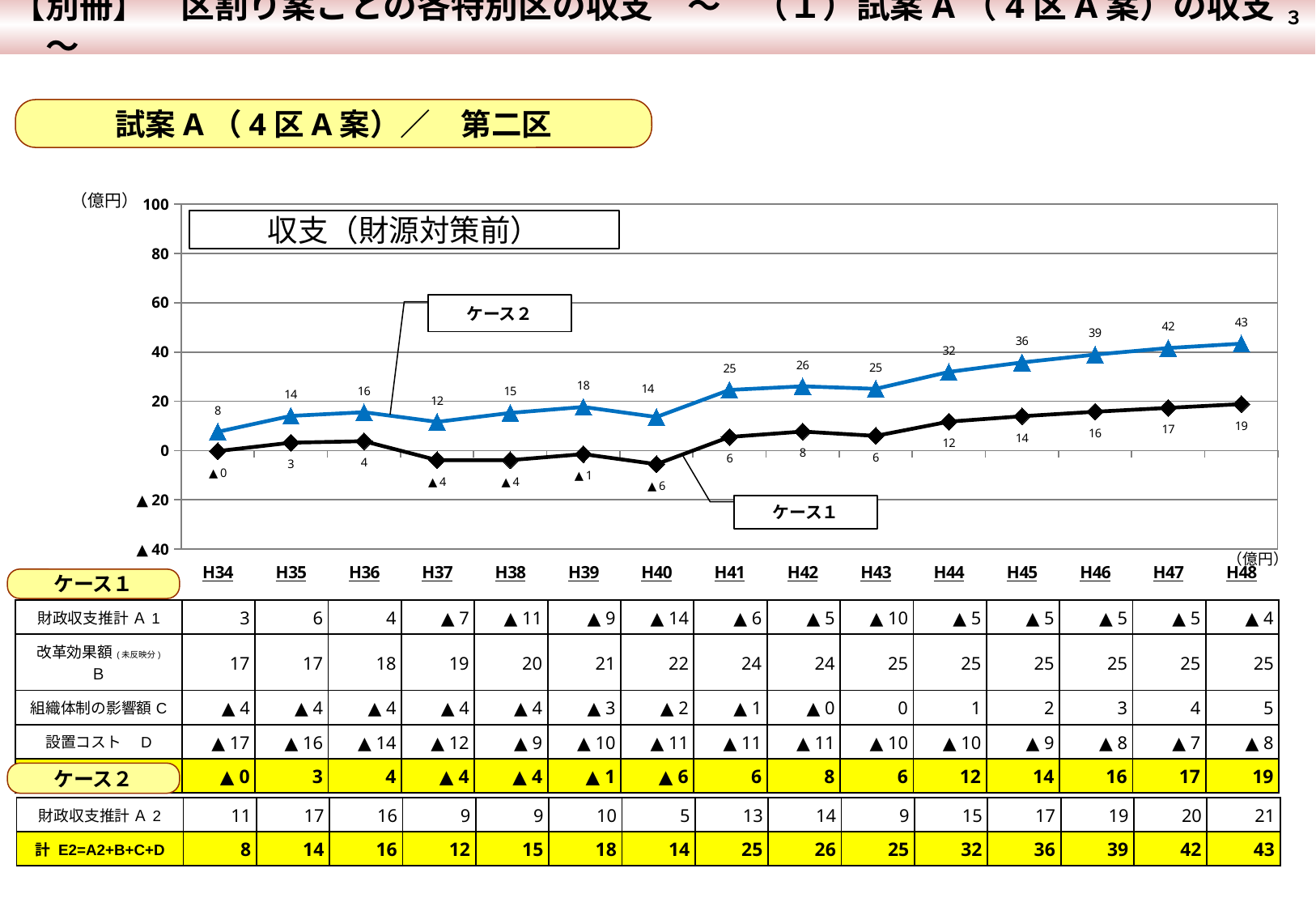
In the chart 収支（財源対策前）, which series has the higher value at H41, ケース1 or ケース2? ケース2 In the chart 収支（財源対策前）, at which year does ケース1 reach its lowest value? H40 In the chart 収支（財源対策前）, what is the difference between ケース2 and ケース1 at H48? 24 In the chart 収支（財源対策前）, is the value for ケース2 at H44 greater or less than 20? greater How many series are plotted in the chart 収支（財源対策前）? 2 How many years (data points) are plotted along the x axis of the chart 収支（財源対策前）? 15 In the chart 収支（財源対策前）, what is the value of ケース2 at H48? 43 What kind of chart is 収支（財源対策前）? line chart What is the title of the chart on the slide? 収支（財源対策前） In the chart 収支（財源対策前）, what is the value of ケース1 at H40? ▲6 In the chart 収支（財源対策前）, does ケース2 rise or fall from H44 to H48? rises In the chart 収支（財源対策前）, at which year does ケース2 reach its highest value? H48